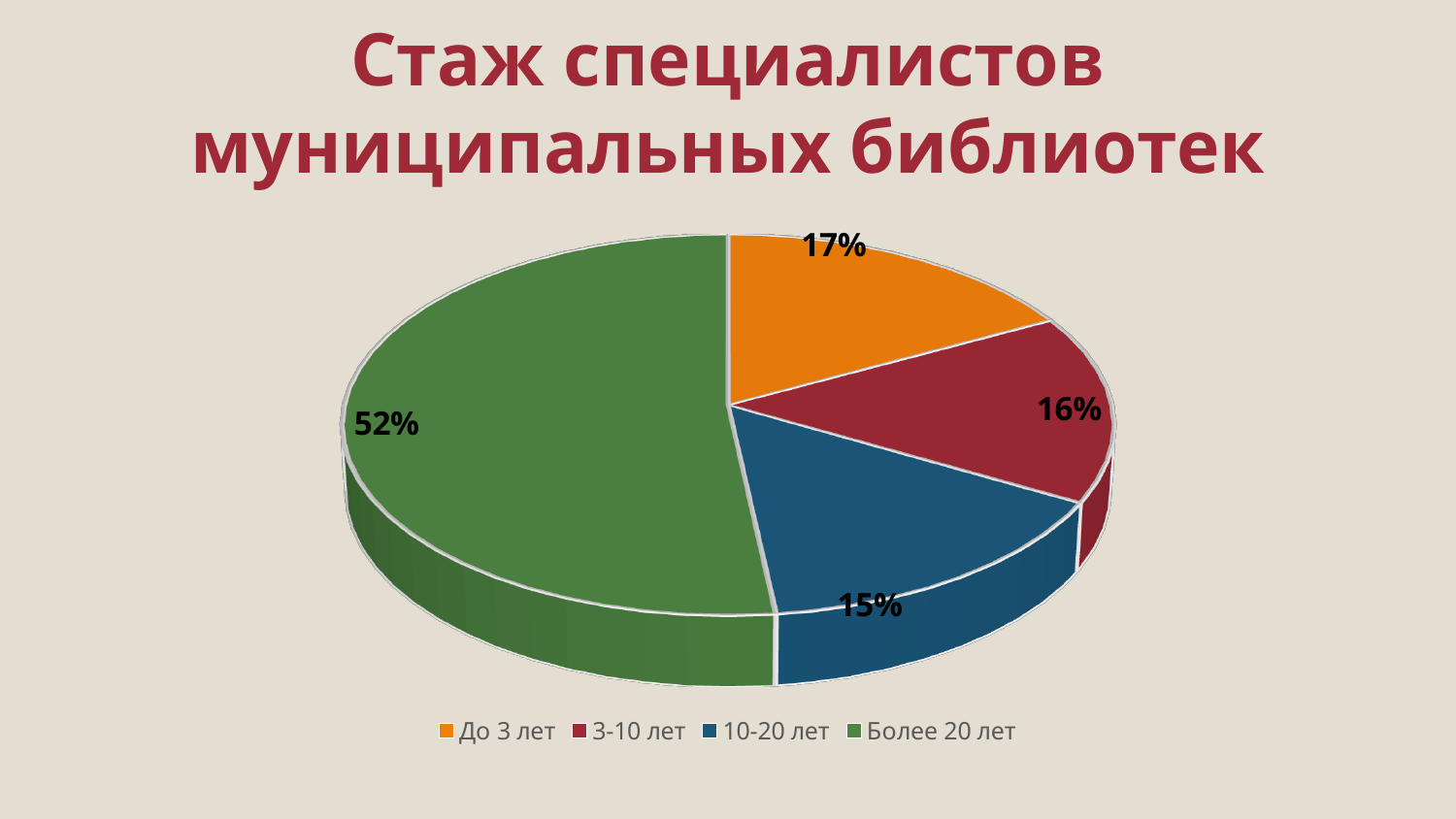
Which category has the largest share of the pie? Более 20 лет What is the value shown for '10-20 лет'? 15% Which category has the smallest share of the pie? 10-20 лет What is the title of the chart? Стаж специалистов муниципальных библиотек What type of chart is shown on the slide? Pie chart What share of the pie does the 'Более 20 лет' slice represent? 52% What is the value shown for 'До 3 лет'? 17% How many categories are shown in the pie chart? 4 What is the value shown for '3-10 лет'? 16% What is the difference between the shares of 'До 3 лет' and '10-20 лет'? 2% What is the difference between the shares of 'Более 20 лет' and 'До 3 лет'? 35% Which is larger, the share for 'Более 20 лет' or the share for '3-10 лет'? Более 20 лет